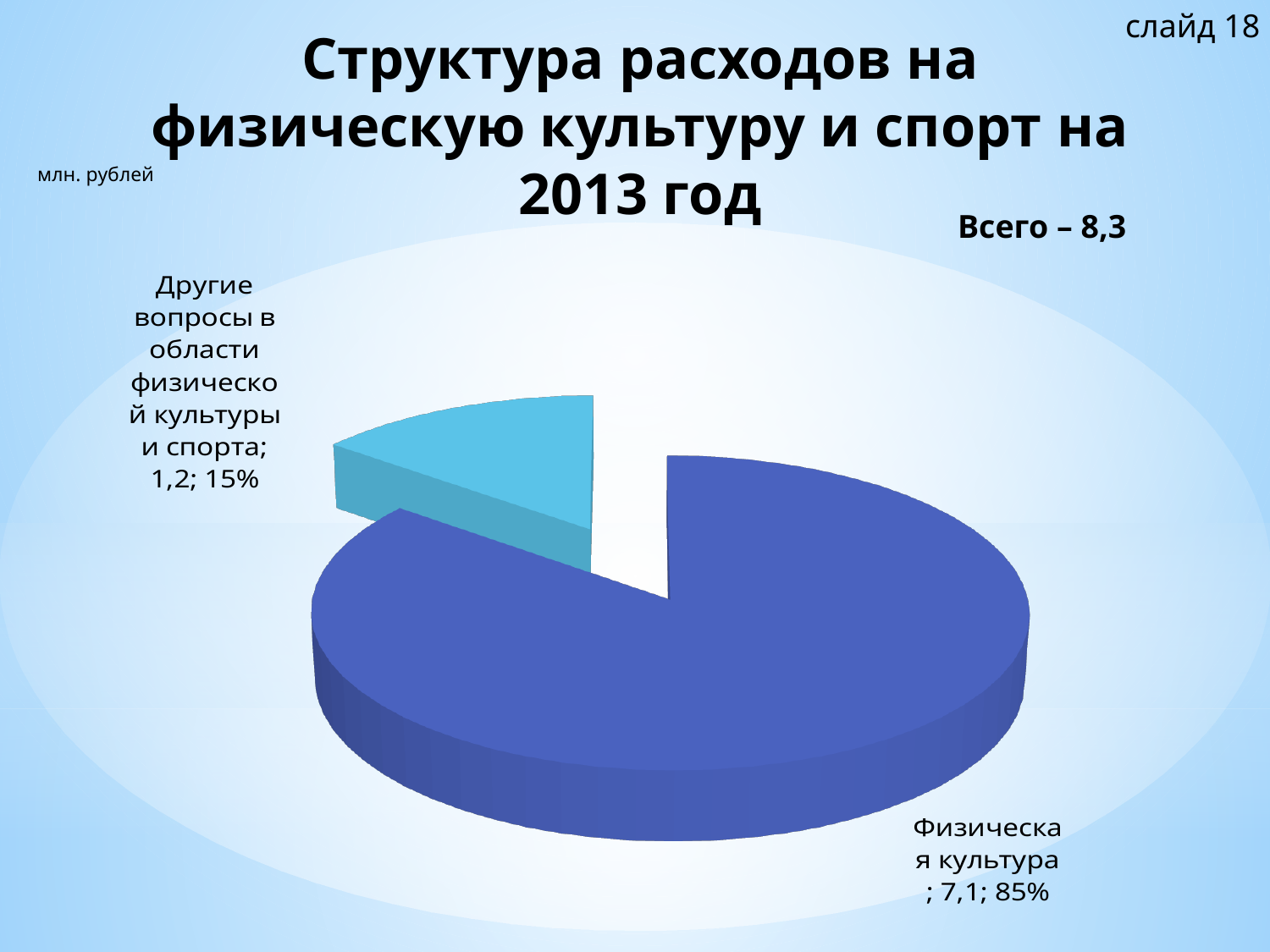
What is the difference between the values for Физическая культура and Другие вопросы в области физической культуры и спорта? 5,9 Which category has the smallest slice? Другие вопросы в области физической культуры и спорта In what units are the values on the chart given? млн. рублей What is the value for Физическая культура? 7,1 What is the value for Другие вопросы в области физической культуры и спорта? 1,2 What share of the pie does Другие вопросы в области физической культуры и спорта take? 15% What total is stated on the slide for the expenditures? 8,3 How many slices does the pie chart have? 2 Which is larger: Физическая культура or Другие вопросы в области физической культуры и спорта? Физическая культура What kind of chart is shown on the slide? pie chart Which category has the largest slice? Физическая культура What share of the pie does Физическая культура take? 85%